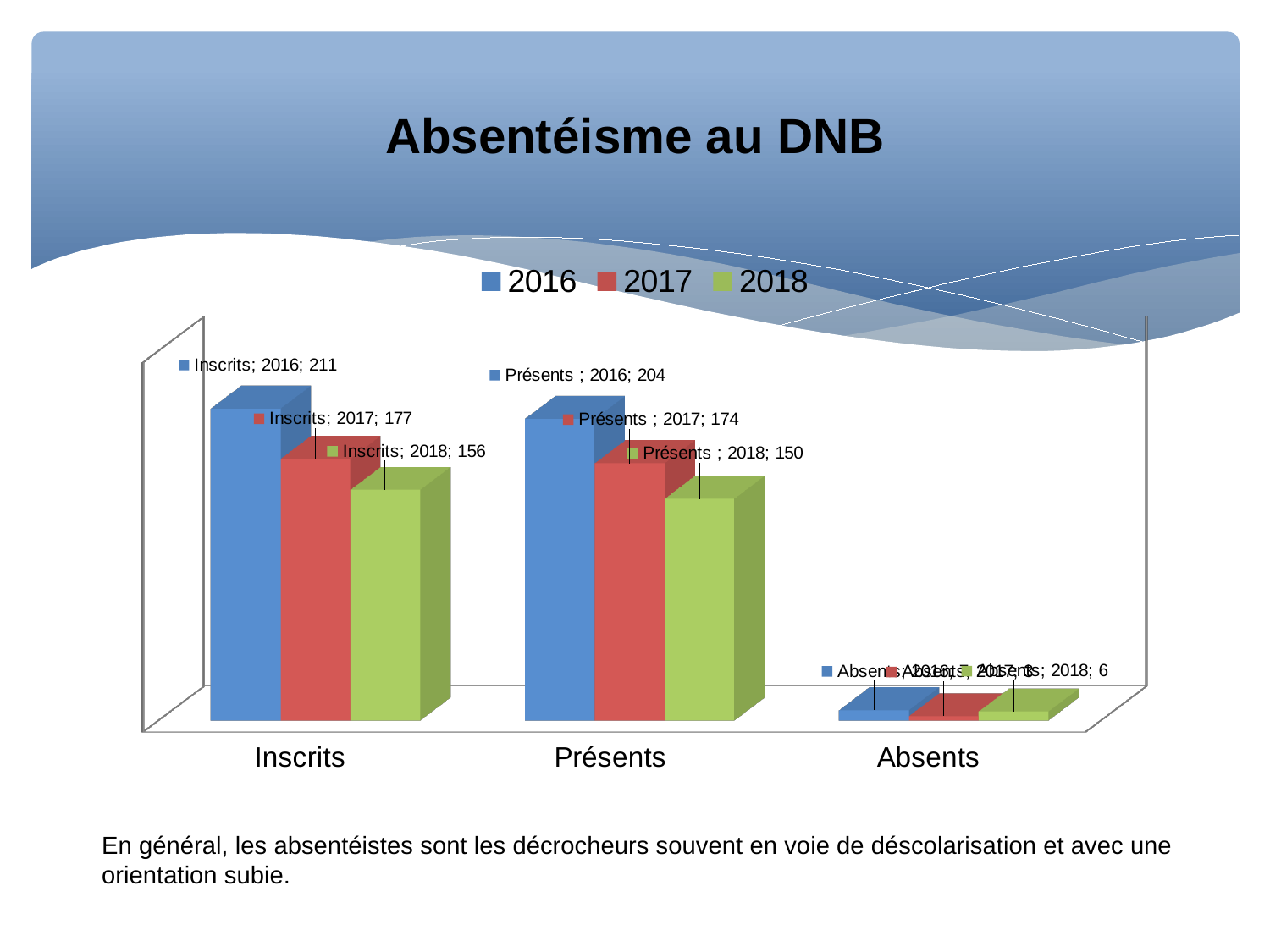
Which year has the lowest value for Présents? 2018 What is the value for Inscrits in 2017? 177 What is the difference between Inscrits in 2016 and Inscrits in 2018? 55 What is the title of the chart? Absentéisme au DNB Which year has the highest value for Inscrits? 2016 What is the value for Présents in 2018? 150 Which is larger: Inscrits in 2017 or Présents in 2016? Présents in 2016 What kind of chart is shown on the slide? Bar chart How many series does the legend list? 3 What is the value for Absents in 2018? 6 What is the difference between Présents in 2017 and Présents in 2018? 24 What is the value for Inscrits in 2016? 211